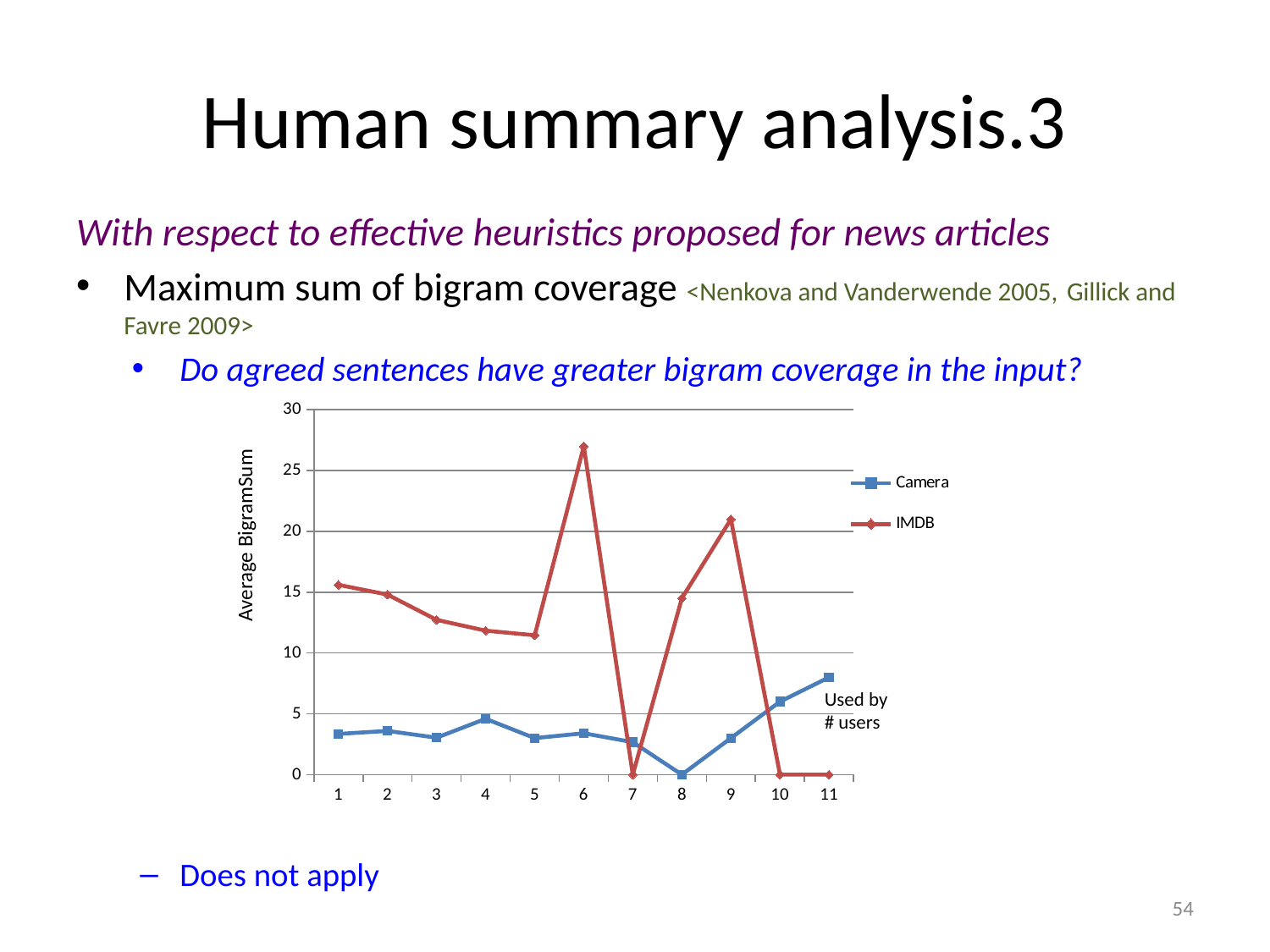
How many series does the legend list? 2 At which x value does the IMDB series reach its highest point? 6 Is the IMDB value at x = 6 greater or less than 25? greater What kind of chart is shown on the slide? line chart What is the IMDB value at x = 11? 0 What is the IMDB value at x = 7? 0 What is the label of the y axis? Average BigramSum Is the Camera value at x = 11 greater or less than 10? less How many points are plotted along the x axis for each series? 11 At x = 1, which series has the larger value, Camera or IMDB? IMDB What is the Camera value at x = 8? 0 What are the two series named in the legend? Camera and IMDB